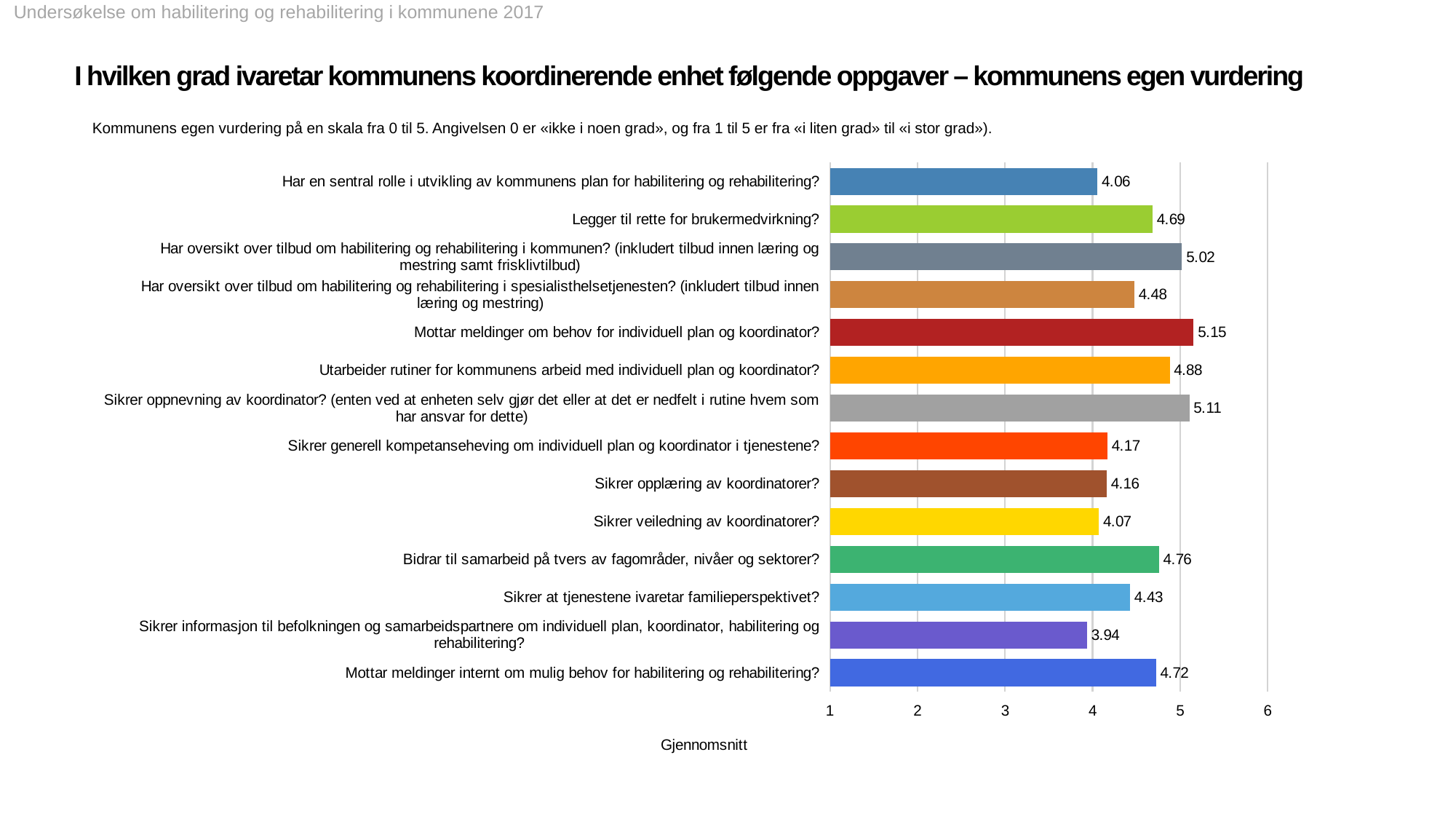
What is the value for "Sikrer at tjenestene ivaretar familieperspektivet?"? 4.43 What is the value for "Legger til rette for brukermedvirkning?"? 4.69 Which category has the highest value? Mottar meldinger om behov for individuell plan og koordinator? What is the title of the horizontal axis? Gjennomsnitt What is the difference between "Utarbeider rutiner for kommunens arbeid med individuell plan og koordinator?" and "Har oversikt over tilbud om habilitering og rehabilitering i spesialisthelsetjenesten?"? 0.40 Which is larger: the value for "Mottar meldinger internt om mulig behov for habilitering og rehabilitering?" or for "Sikrer at tjenestene ivaretar familieperspektivet?"? Mottar meldinger internt om mulig behov for habilitering og rehabilitering? What is the difference between the highest value (5.15) and the lowest value (3.94)? 1.21 Is the value for "Sikrer informasjon til befolkningen og samarbeidspartnere om individuell plan, koordinator, habilitering og rehabilitering?" greater or less than 4? less Which category has the lowest value? Sikrer informasjon til befolkningen og samarbeidspartnere om individuell plan, koordinator, habilitering og rehabilitering? What is the value for "Utarbeider rutiner for kommunens arbeid med individuell plan og koordinator?"? 4.88 How many categories are shown in the chart? 14 What kind of chart is shown on the slide? Bar chart